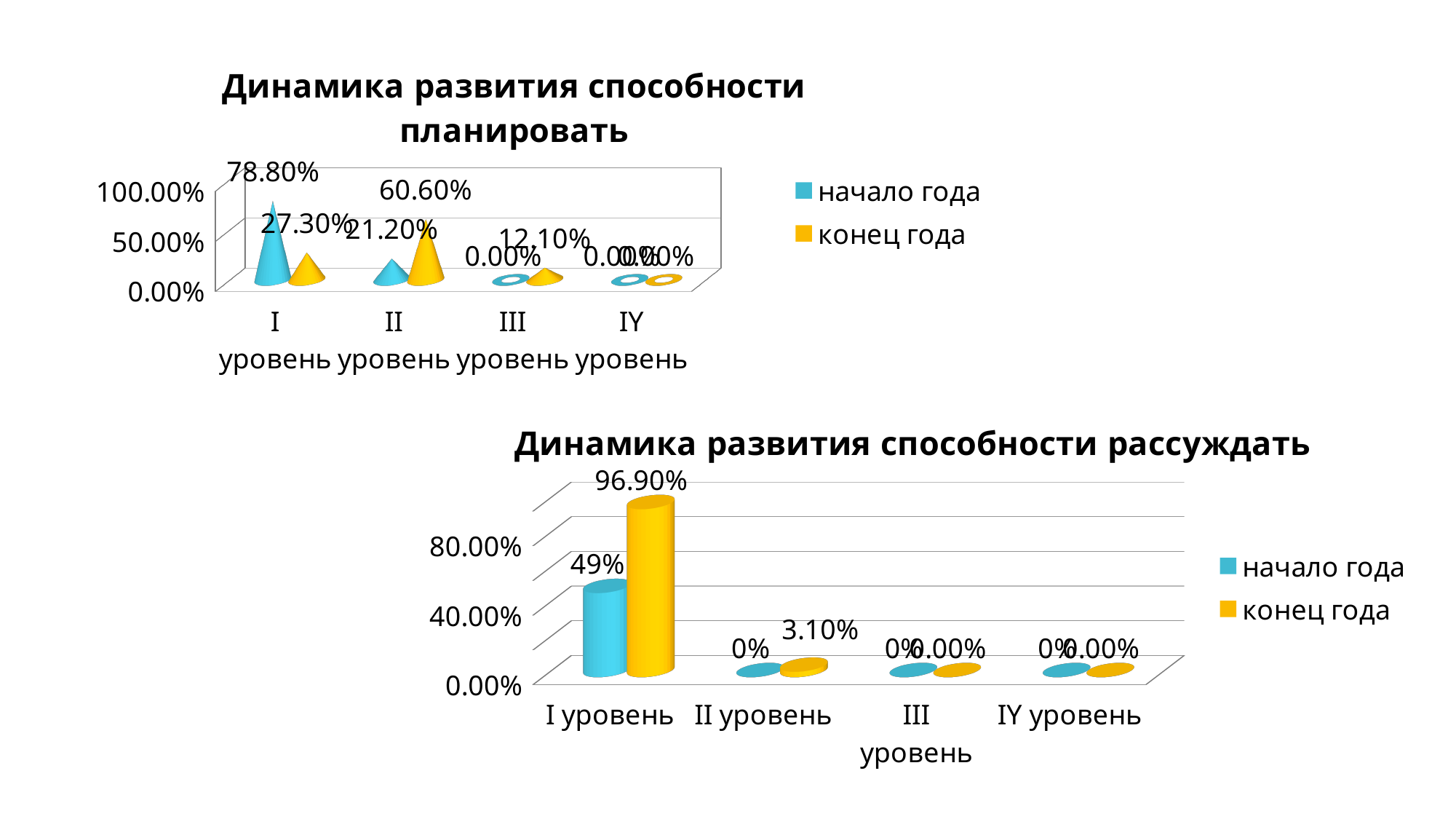
In the chart 'Динамика развития способности рассуждать', what is the value for 'начало года' at I уровень? 49% In the chart 'Динамика развития способности планировать', what is the value for 'конец года' at III уровень? 12.10% In the chart 'Динамика развития способности рассуждать', what is the value for 'конец года' at II уровень? 3.10% In the chart 'Динамика развития способности рассуждать', what is the value for 'конец года' at I уровень? 96.90% What kind of chart is 'Динамика развития способности рассуждать'? bar chart In the chart 'Динамика развития способности планировать', what is the value for 'начало года' at I уровень? 78.80% In the chart 'Динамика развития способности планировать', which level has the highest value for 'начало года'? I уровень In the chart 'Динамика развития способности рассуждать', which is larger at I уровень: 'начало года' or 'конец года'? конец года In the chart 'Динамика развития способности планировать', how many series does the legend list? 2 In the chart 'Динамика развития способности рассуждать', how many levels are shown on the x axis? 4 In the chart 'Динамика развития способности планировать', what is the value for 'конец года' at II уровень? 60.60% In the chart 'Динамика развития способности планировать', what is the difference between 'начало года' and 'конец года' at I уровень? 51.50%